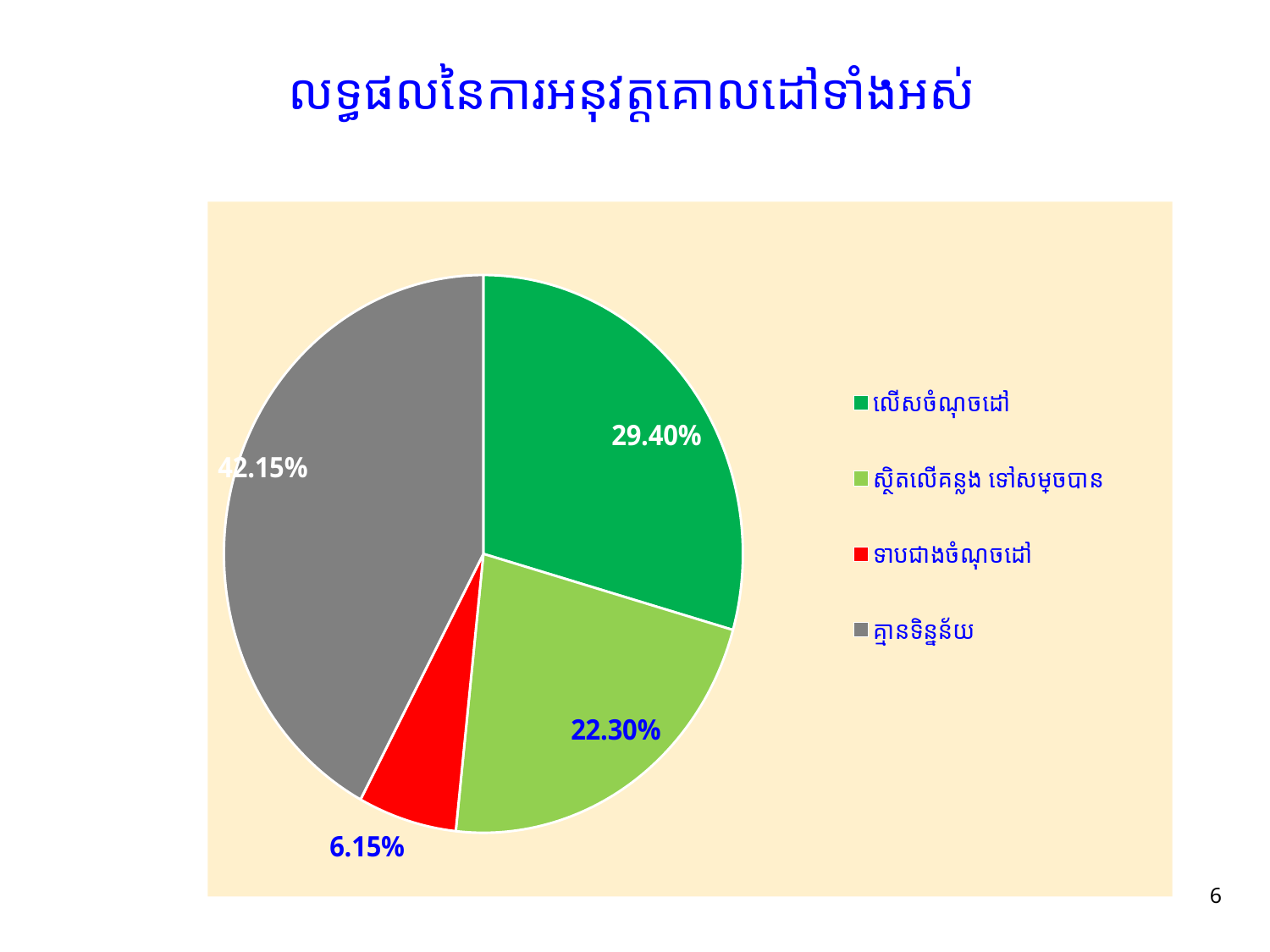
How many slices does the pie chart have? 4 Which category has the largest slice of the pie? គ្មានទិន្នន័យ What is the value of the slice for ស្ថិតលើគន្លង ទៅសម្រេចបាន? 22.30% What kind of chart is shown on the slide? Pie chart Which category has the smallest slice of the pie? ទាបជាងចំណុចដៅ What colour is the slice for ទាបជាងចំណុចដៅ? Red What is the title of the chart slide? លទ្ធផលនៃការអនុវត្តគោលដៅទាំងអស់ Which is larger, the slice for លើសចំណុចដៅ or the slice for ស្ថិតលើគន្លង ទៅសម្រេចបាន? លើសចំណុចដៅ What is the value of the slice for លើសចំណុចដៅ? 29.40% What is the difference between the slices for គ្មានទិន្នន័យ and លើសចំណុចដៅ? 12.75% What is the value of the slice for គ្មានទិន្នន័យ? 42.15% What is the value of the slice for ទាបជាងចំណុចដៅ? 6.15%